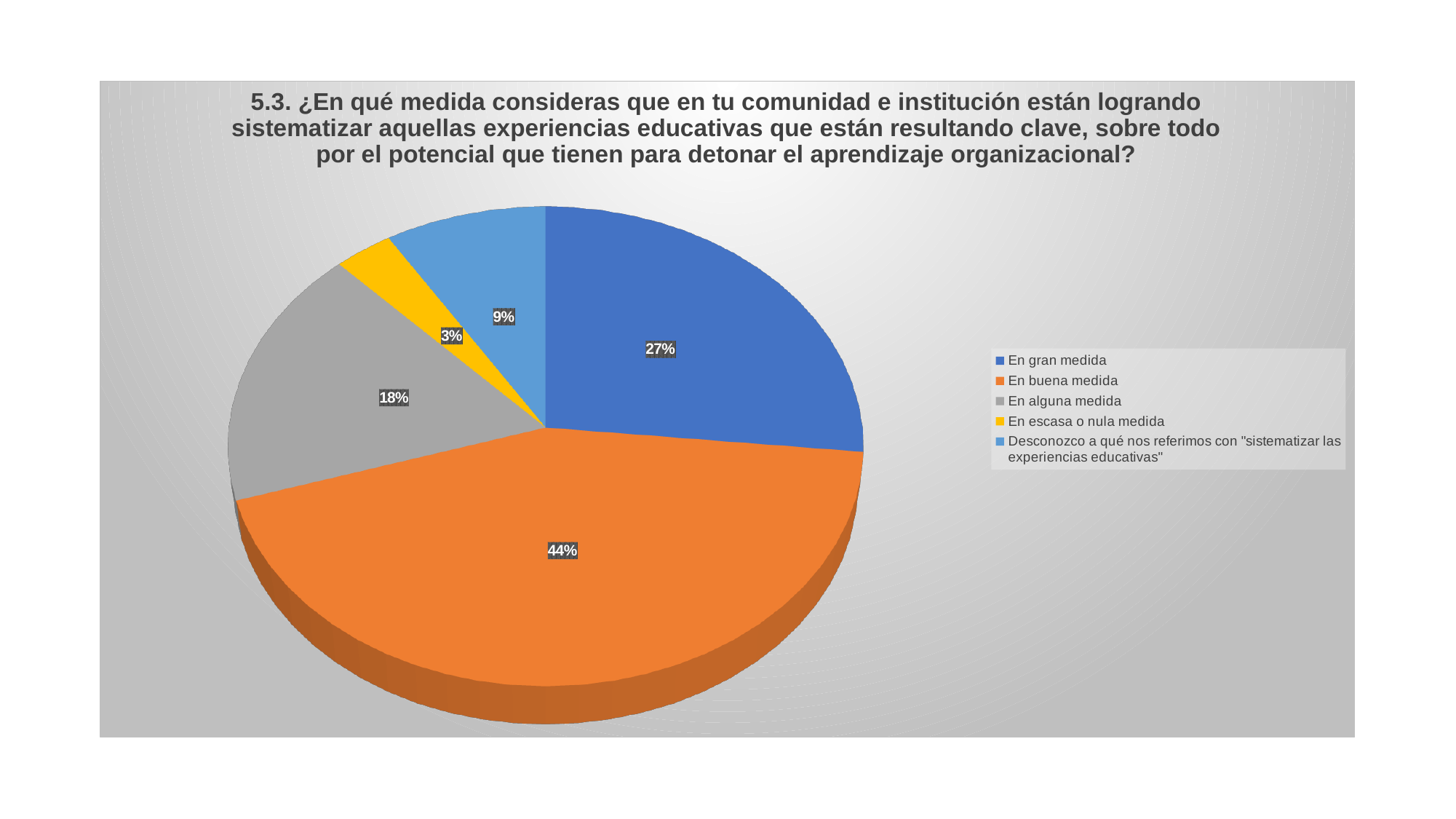
What share of the pie does "En gran medida" represent? 27% Which category has the largest slice of the pie? En buena medida What share of the pie does "En alguna medida" represent? 18% How many categories does the pie chart show? 5 What share of the pie does "En buena medida" represent? 44% What is the difference in percentage points between "En buena medida" and "En gran medida"? 17 What colour is the slice for "En escasa o nula medida"? Yellow What kind of chart is shown on the slide? Pie chart Which category has the smallest slice of the pie? En escasa o nula medida Which is larger, the slice for "En alguna medida" or the slice for "En gran medida"? En gran medida